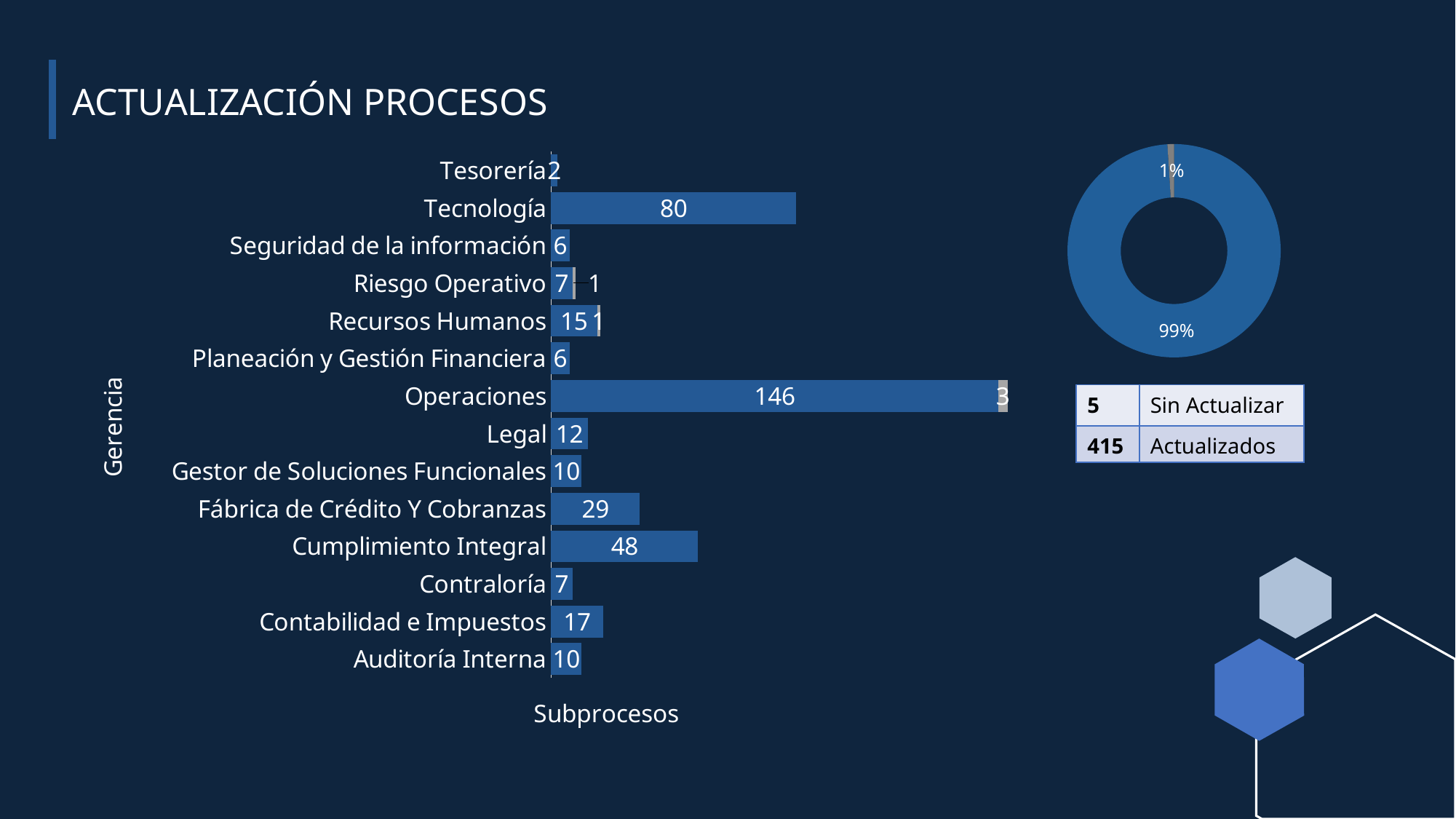
What is the title of the horizontal axis of the bar chart? Subprocesos In the bar chart, what is the total of the Operaciones bar including the grey segment (146 and 3)? 149 In the bar chart, what is the value of the blue bar for Fábrica de Crédito Y Cobranzas? 29 In the donut chart, what share does the large blue segment represent? 99% In the bar chart, which gerencia has the lowest number of subprocesos? Tesorería In the bar chart, which has a larger blue bar value, Legal or Contabilidad e Impuestos? Contabilidad e Impuestos How many gerencias are listed in the bar chart? 14 In the bar chart, what is the difference between the blue bar values for Tecnología and Cumplimiento Integral? 32 In the bar chart, what is the value of the blue bar for Cumplimiento Integral? 48 In the bar chart, which gerencia has the highest number of subprocesos? Operaciones In the bar chart, what is the value of the blue bar for Tecnología? 80 What type of chart is the chart on the left of the slide? Bar chart